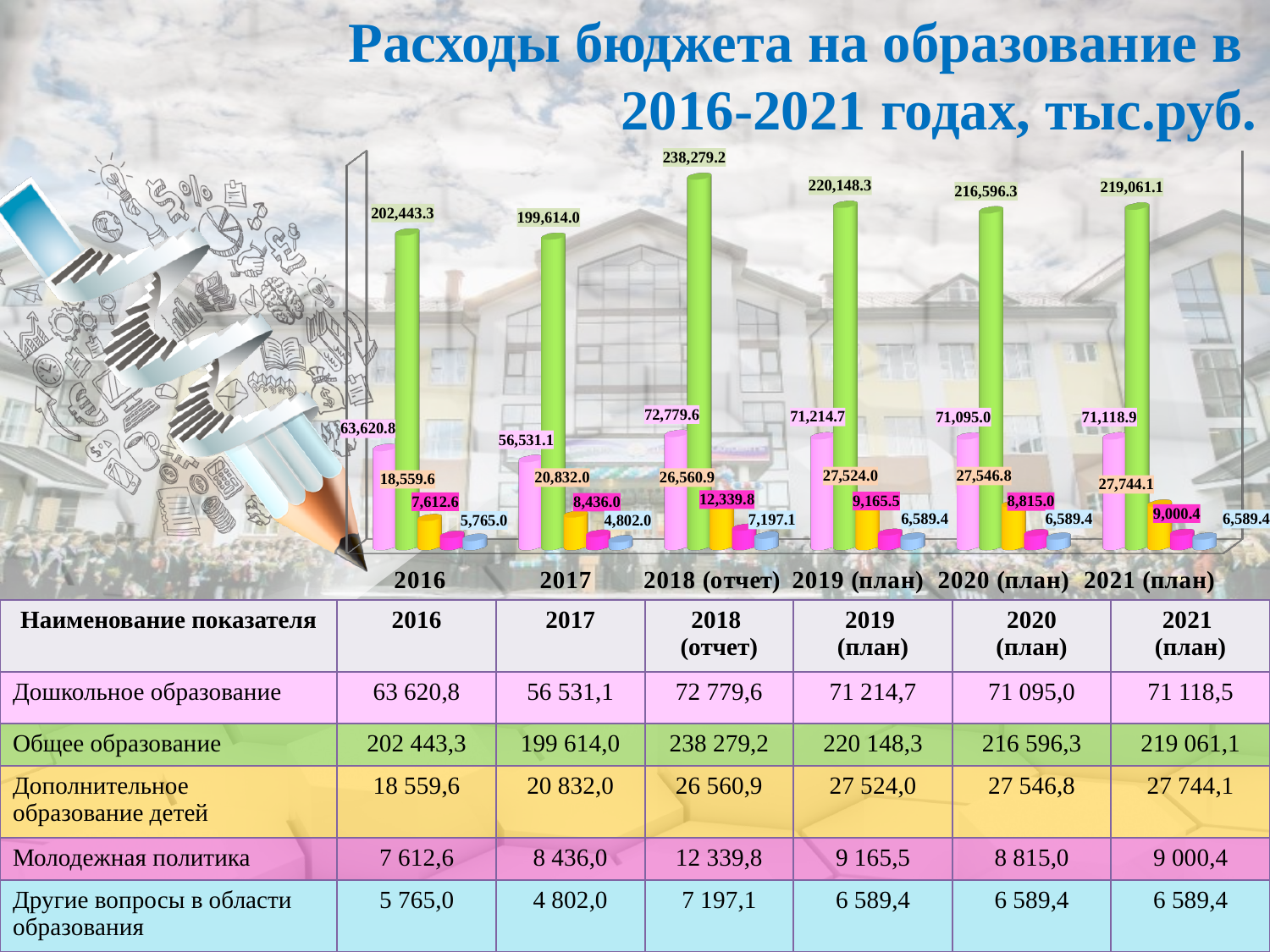
What is the value labelled on the green bar for 2016 in the chart? 202,443.3 Does the light blue (Другие вопросы в области образования) bar rise or fall from 2016 to 2017 in the chart? fall What kind of chart is shown on the slide? bar chart How many year categories are shown along the x axis of the chart? 6 What is the difference between the green bar values for 2018 (отчет) and 2019 (план) in the chart? 18,130.9 What is the value of the yellow (Дополнительное образование детей) bar for 2020 (план) in the chart? 27,546.8 How many bars (series) are plotted for each year in the chart? 5 In which year is the pink (Дошкольное образование) bar lowest in the chart? 2017 What is the value of the pink (Дошкольное образование) bar for 2017 in the chart? 56,531.1 What is the value of the tallest (green) bar for 2018 (отчет) in the chart? 238,279.2 Which is larger in the chart: the magenta (Молодежная политика) bar for 2018 (отчет) or for 2019 (план)? 2018 (отчет) In which year does the green (Общее образование) bar reach its highest value in the chart? 2018 (отчет)